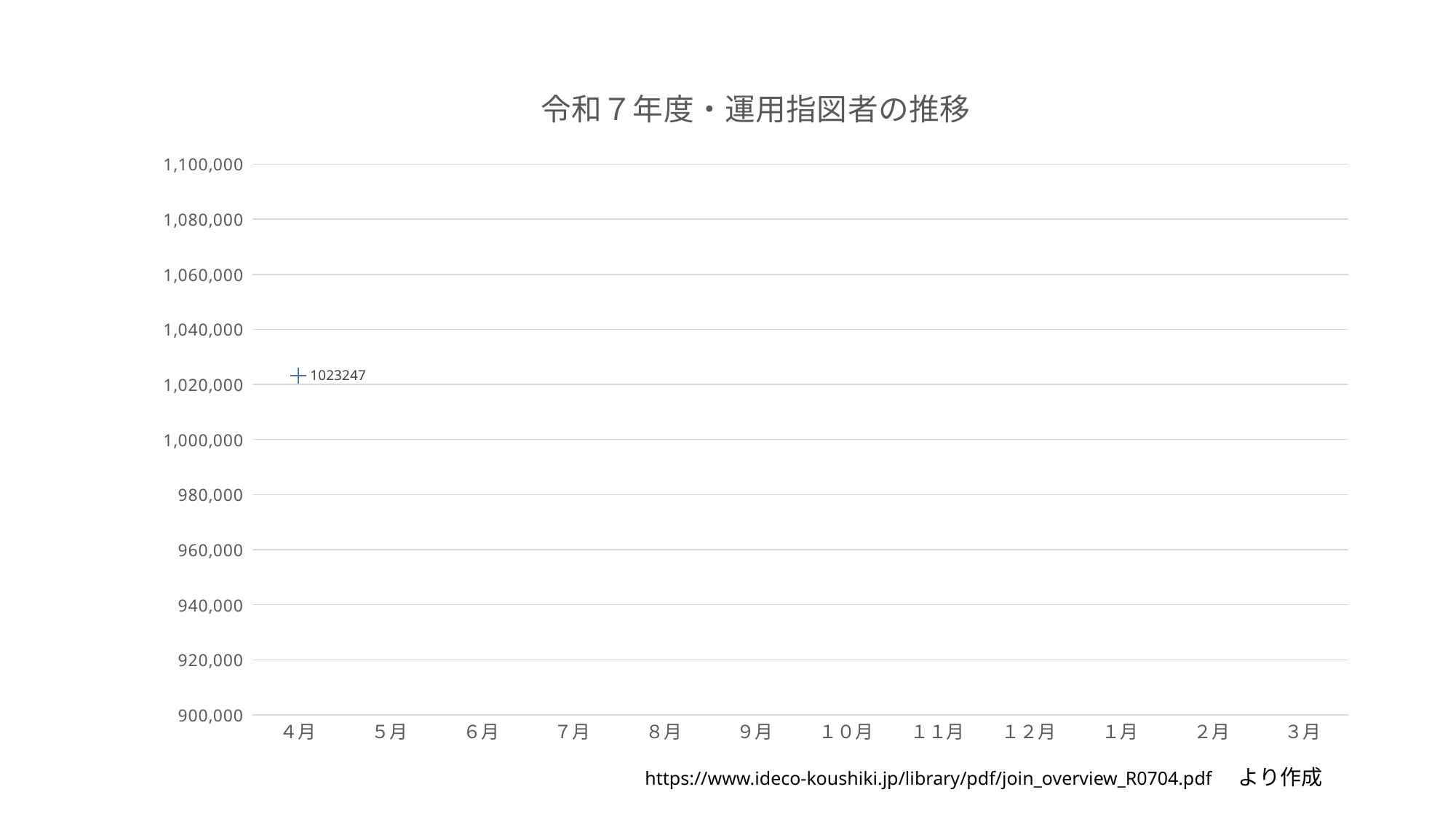
What is the title of the chart? 令和７年度・運用指図者の推移 How many month categories are shown on the x axis? 12 What is the highest value shown on the y axis? 1,100,000 Is the value for 4月 greater or less than 1,000,000? greater Is the value for 4月 greater or less than 1,040,000? less How many data points are plotted on the chart? 1 What is the lowest value shown on the y axis? 900,000 What is the value plotted for 4月? 1023247